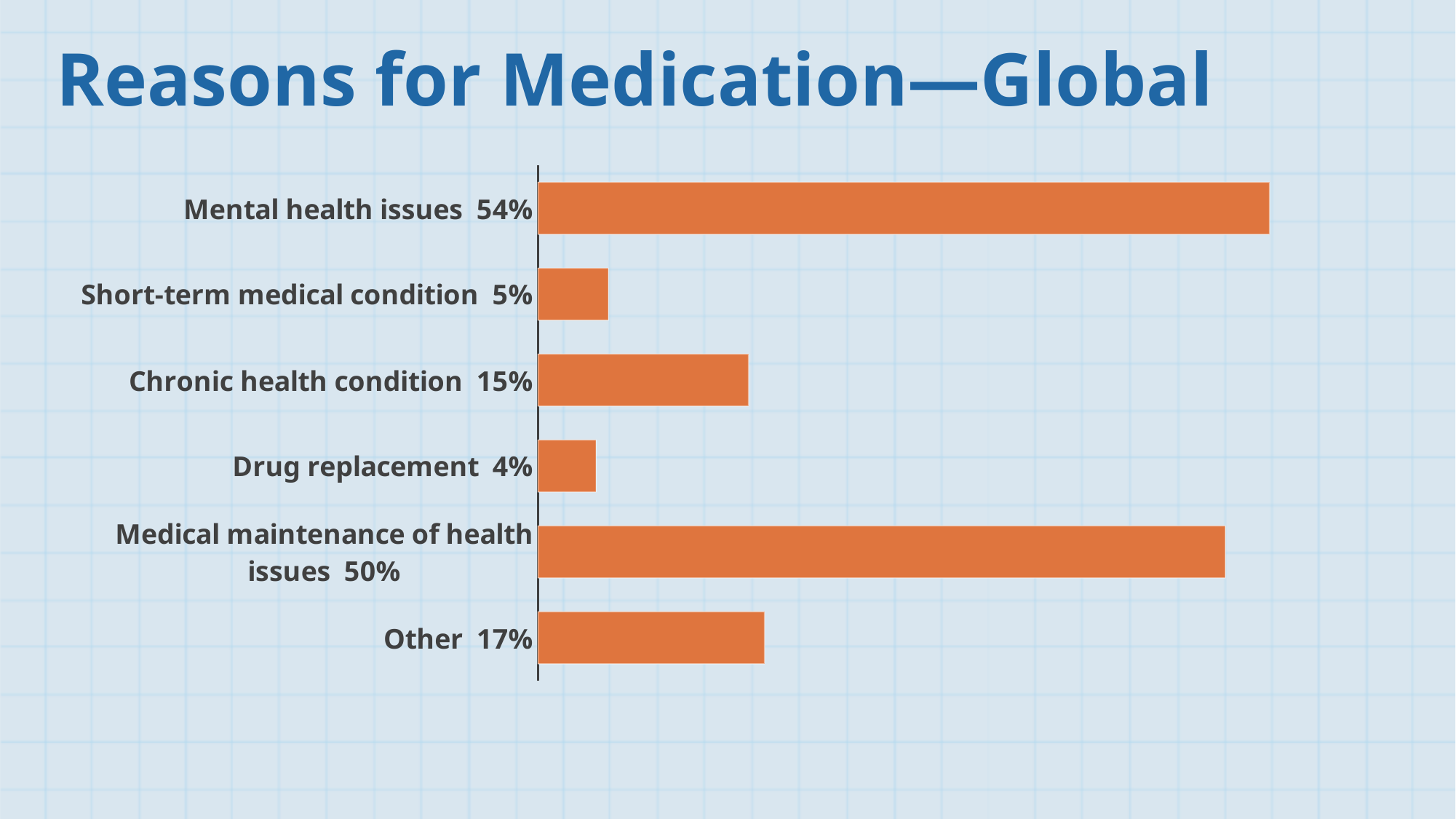
What kind of chart is shown on the slide? Bar chart What is the title of the slide? Reasons for Medication—Global What is the difference between Mental health issues and Medical maintenance of health issues? 4% What is the value for Mental health issues? 54% Which is larger, Short-term medical condition or Chronic health condition? Chronic health condition What is the value for Other? 17% How many categories are shown in the chart? 6 What is the value for Medical maintenance of health issues? 50% What is the value for Chronic health condition? 15% Which category has the lowest value? Drug replacement Which category has the highest value? Mental health issues What is the difference between Other and Chronic health condition? 2%